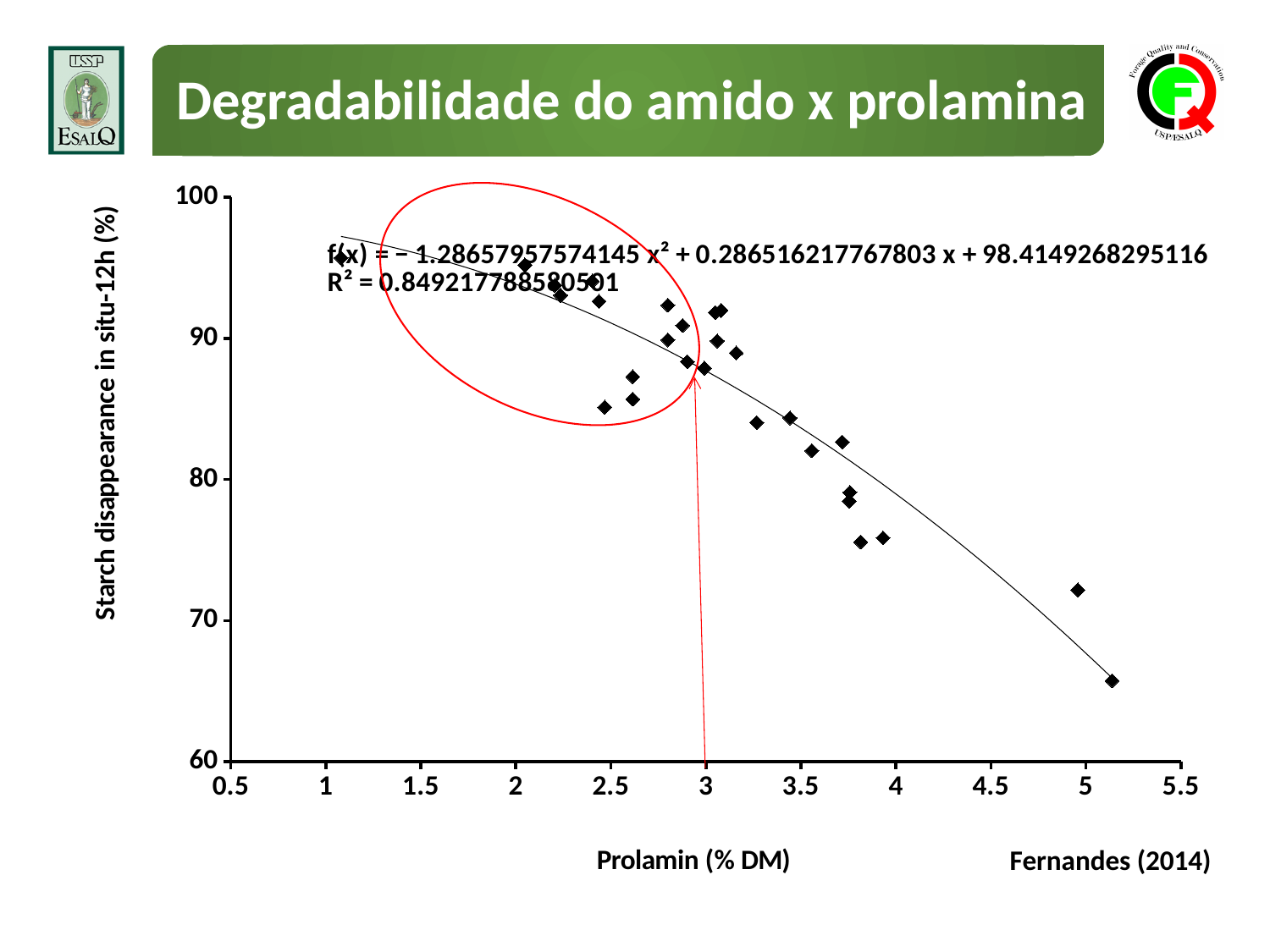
Is the starch disappearance value for the point with the highest prolamin (just above 5 % DM) greater or less than 70? less Is the starch disappearance value for the point at about 1 % DM prolamin greater or less than 90? greater What kind of chart is shown on the slide? scatter plot What R² value is printed on the chart? 0.849217788580501 What is the highest value shown on the y axis? 100 What is the lowest value shown on the x axis? 0.5 Are the starch disappearance values for the points near 3.8–3.9 % DM prolamin greater or less than 80? less What is the label of the x axis? Prolamin (% DM) Which point has the lowest starch disappearance: the one at about 1 % DM prolamin or the one at about 5.1 % DM prolamin? the one at about 5.1 % DM prolamin As prolamin increases along the x axis, does starch disappearance generally rise or fall? fall What is the label of the y axis? Starch disappearance in situ-12h (%)